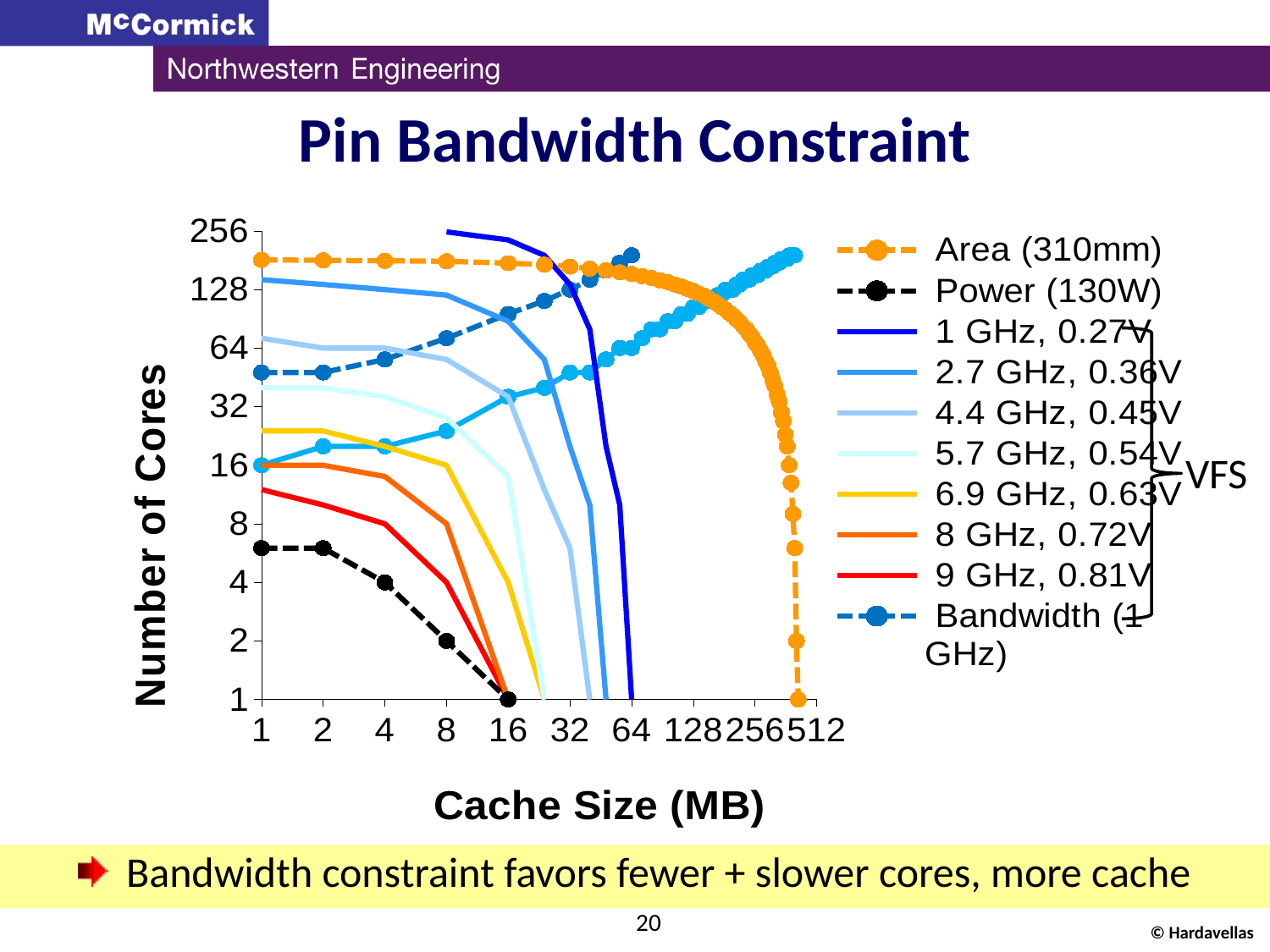
Is the value of the Area (310mm) series at a cache size of 1 MB greater or less than 128? greater Does the Bandwidth (1 GHz) series rise or fall as cache size increases? rise What kind of chart is shown on the slide? line chart What is the title of the chart's x axis? Cache Size (MB) Is the value of the Bandwidth (1 GHz) series at a cache size of 1 MB greater or less than 32? greater Does the Power (130W) series rise or fall as cache size increases? fall At a cache size of 1 MB, which series has the larger value: Area (310mm) or Power (130W)? Area (310mm) How many cache size values are marked on the x axis? 10 How many series does the legend list? 10 Is the value of the Power (130W) series at a cache size of 1 MB greater or less than 8? less What is the title of the chart's y axis? Number of Cores What is the value of the Power (130W) series at a cache size of 16 MB? 1